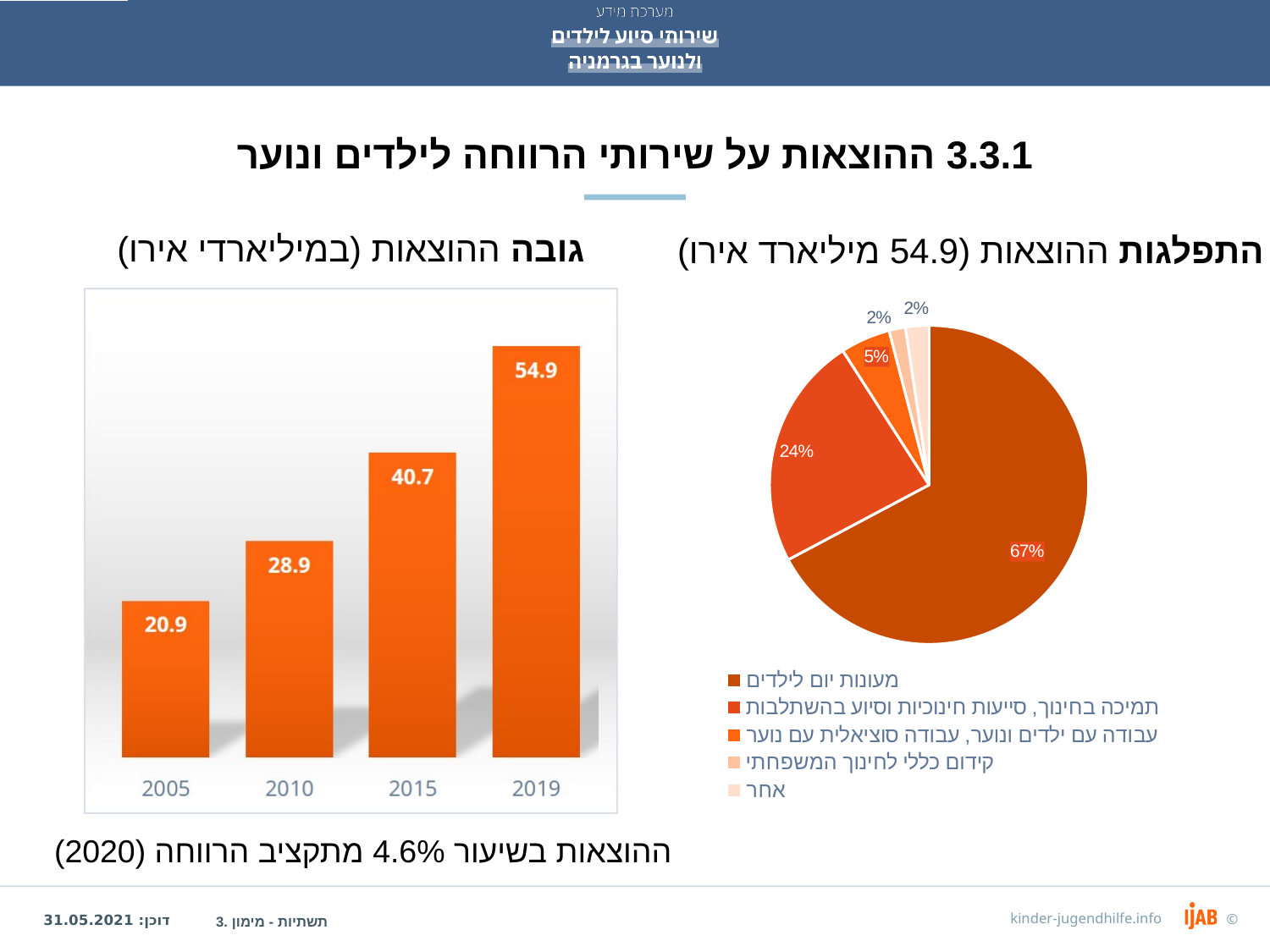
In the bar chart on the left, do the values rise or fall from 2005 to 2019? rise In the bar chart on the left, what is the difference between the values for 2015 and 2010? 11.8 How many entries does the legend of the pie chart on the right list? 5 In the pie chart on the right, what share does the slice for תמיכה בחינוך, סייעות חינוכיות וסיוע בהשתלבות have? 24% What kind of chart is shown on the left side of the slide? bar chart In the bar chart on the left, which year has the lowest value? 2005 In the pie chart on the right, which is larger: the slice for עבודה עם ילדים ונוער, עבודה סוציאלית עם נוער or the slice for אחר? עבודה עם ילדים ונוער, עבודה סוציאלית עם נוער In the bar chart on the left, what is the value for 2019? 54.9 How many bars are in the bar chart on the left? 4 In the bar chart on the left, which year has the highest value? 2019 In the pie chart on the right, what share does the slice for מעונות יום לילדים have? 67% In the bar chart on the left, what is the value for 2005? 20.9